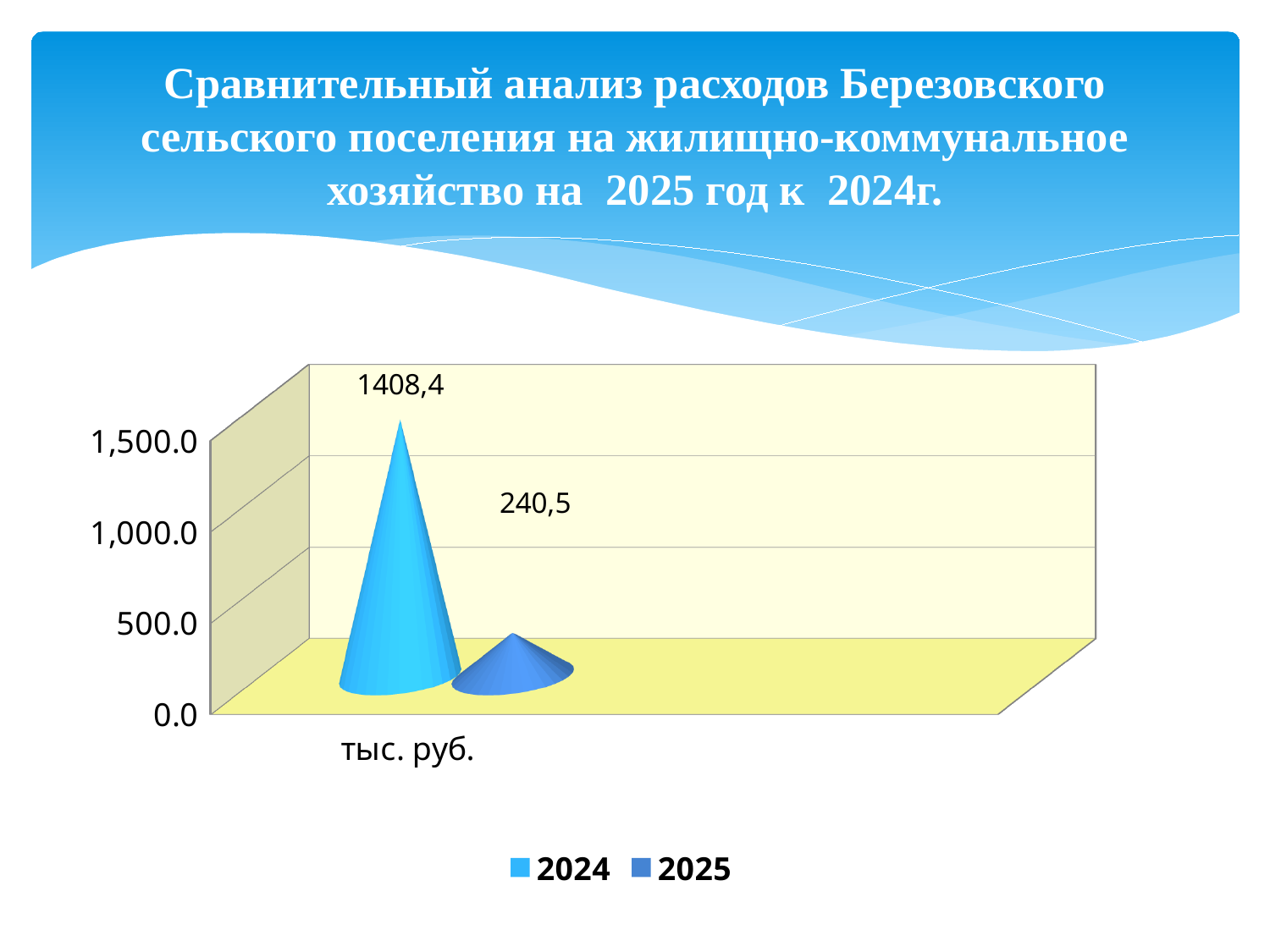
How many series does the legend list? 2 Is the value for 2025 greater or less than 500.0? less What is the category label shown on the x axis? тыс. руб. How many categories are shown on the x axis? 1 Which series has the higher value, 2024 or 2025? 2024 What is the value for 2025? 240,5 What is the value for 2024? 1408,4 What kind of chart is shown on the slide? bar chart Is the value for 2024 greater or less than 1,000.0? greater What is the difference between the 2024 value and the 2025 value? 1167,9 Which series has the lowest value? 2025 What is the highest tick value shown on the vertical axis? 1,500.0